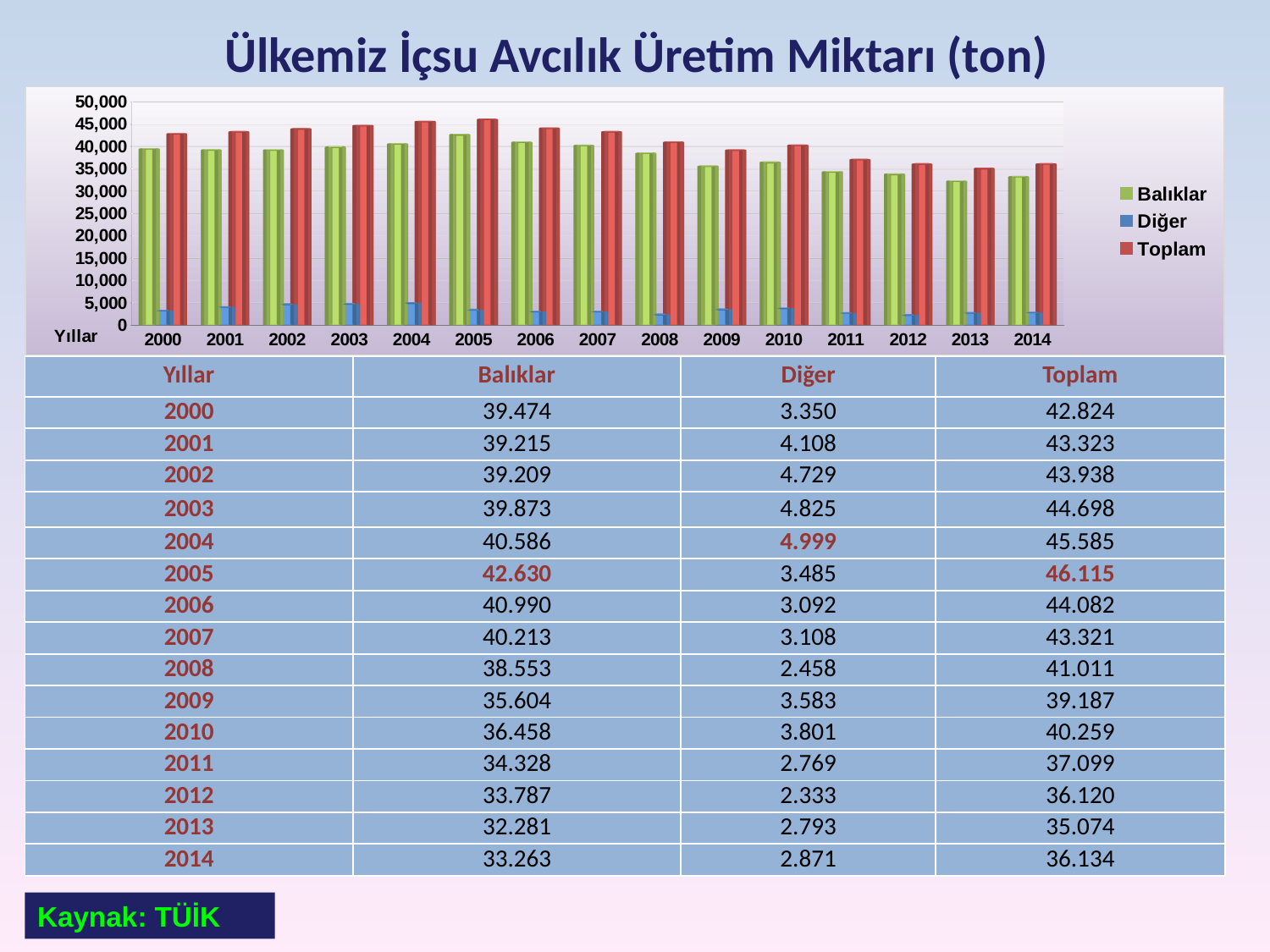
Does the Toplam series generally rise or fall from 2005 to 2014? fall What is the difference between the Toplam value for 2005 and the Toplam value for 2014? 9.981 In which year is the Toplam value lowest? 2013 In which year is the Diğer value highest? 2004 What is the Balıklar value for 2000? 39.474 How many series does the chart legend list? 3 What is the Toplam value for 2005? 46.115 Is the Balıklar value for 2013 greater or less than 35,000? less In which year is the Toplam value highest? 2005 Which is larger, the Balıklar value for 2004 or for 2005? 2005 What kind of chart is shown on the slide? bar chart How many years are shown along the x axis of the chart? 15